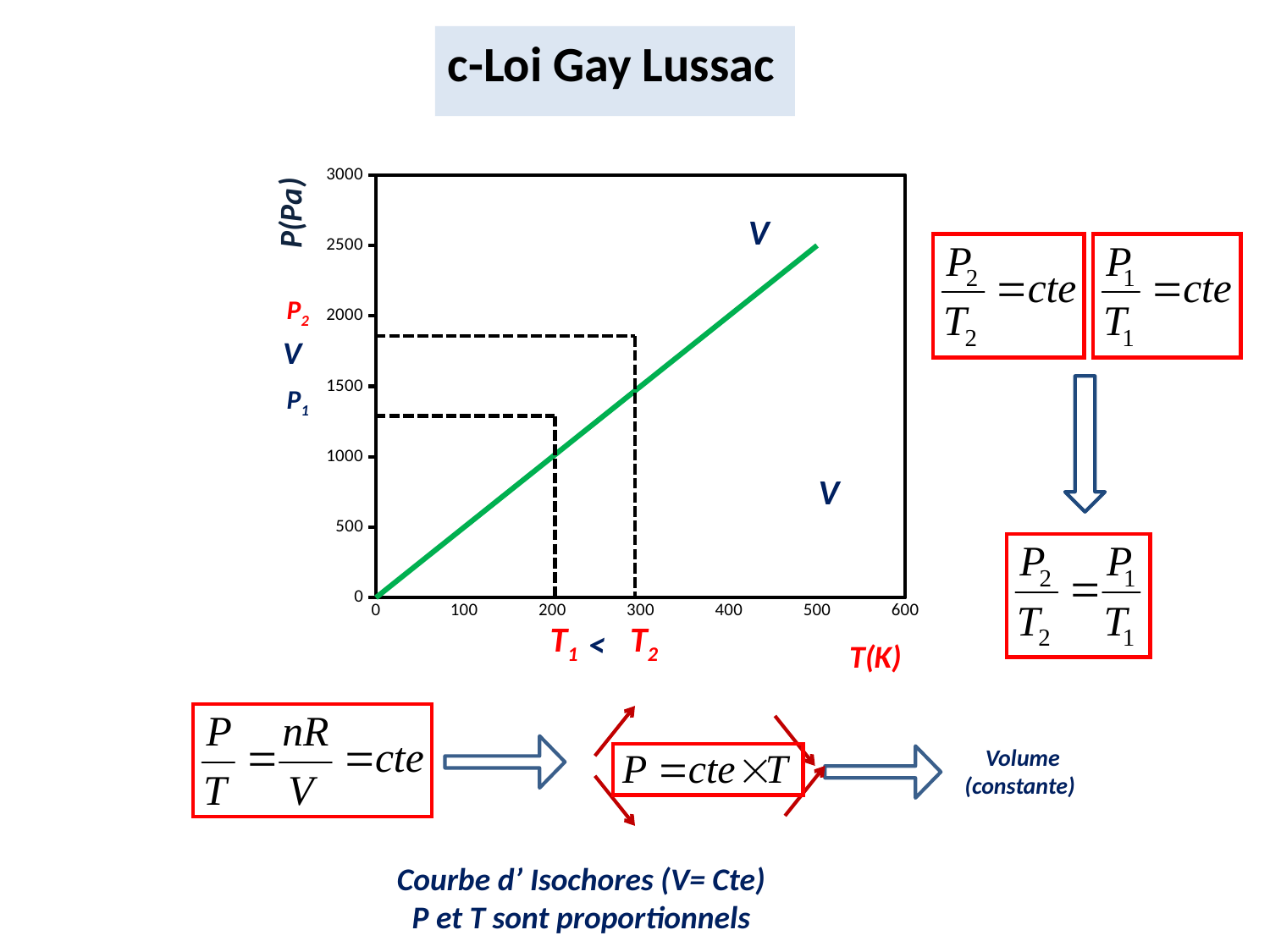
How many lines (series) are plotted on the chart? 1 Does the pressure P rise or fall as the temperature T increases along the x axis? rises What kind of chart is shown on the slide? line chart Is the value of P at T = 400 greater or less than 1500? greater What is the label of the y axis of the chart? P(Pa) What is the highest tick value shown on the y axis? 3000 What is the value of P where the line starts at T = 0? 0 What is the label of the x axis of the chart? T(K) Is the value of P at T = 100 greater or less than 1000? less Which is larger on the chart, the pressure P1 at T1 or the pressure P2 at T2? P2 Is the value of P at T = 300 greater or less than 2000? less